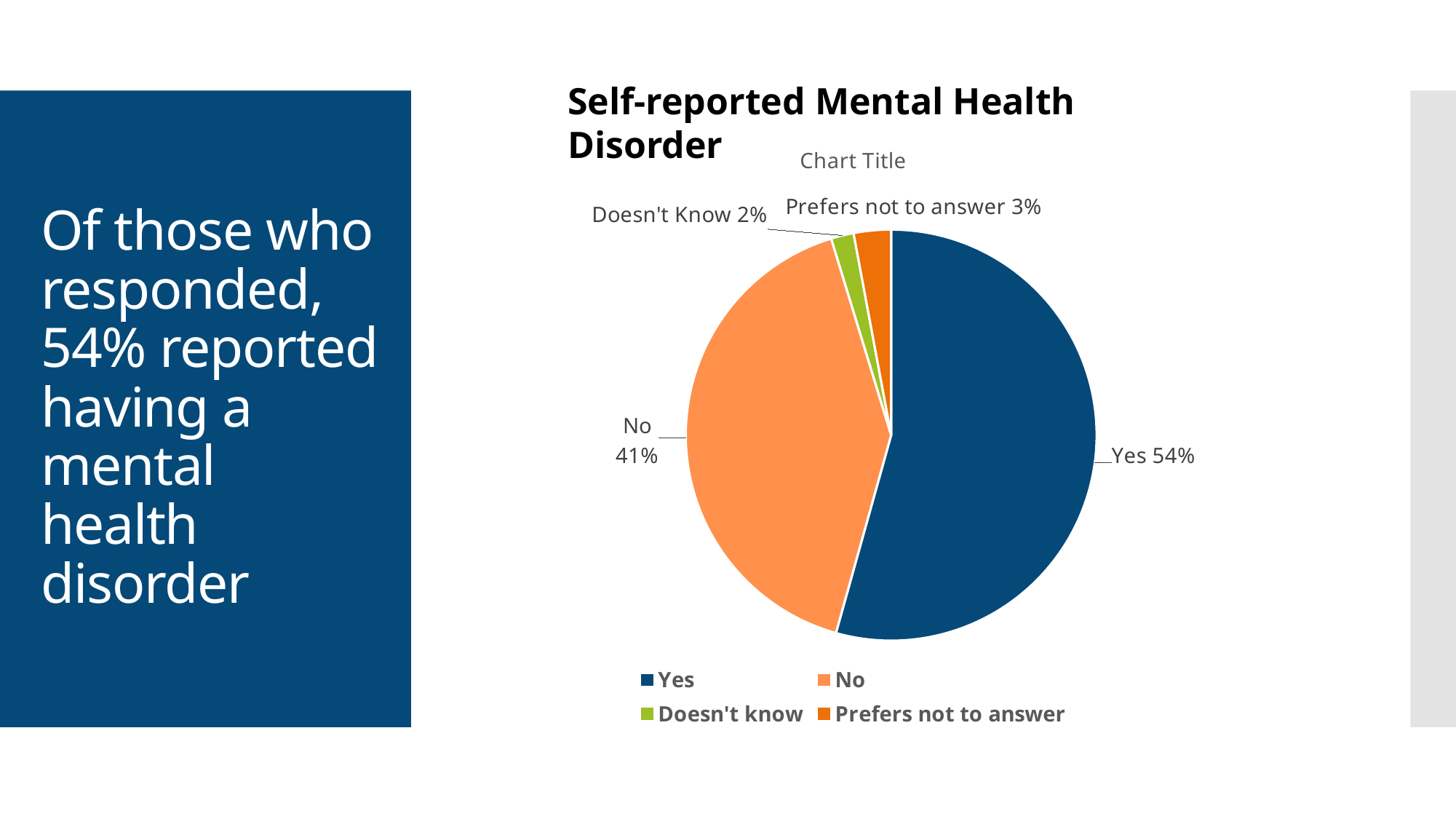
What is the bold title above the pie chart? Self-reported Mental Health Disorder What share of the pie is labelled Doesn't Know? 2% What colour is the Yes slice in the pie chart? Dark blue What is the difference in percentage points between the Yes and No slices? 13 What kind of chart is shown on the slide? Pie chart What percentage of respondents answered No? 41% What share of the pie is labelled Prefers not to answer? 3% Which category has the smallest slice of the pie? Doesn't Know Which slice is larger, Prefers not to answer or Doesn't Know? Prefers not to answer What percentage of respondents answered Yes in the Self-reported Mental Health Disorder pie chart? 54% How many categories does the pie chart show? 4 Which category has the largest slice of the pie? Yes